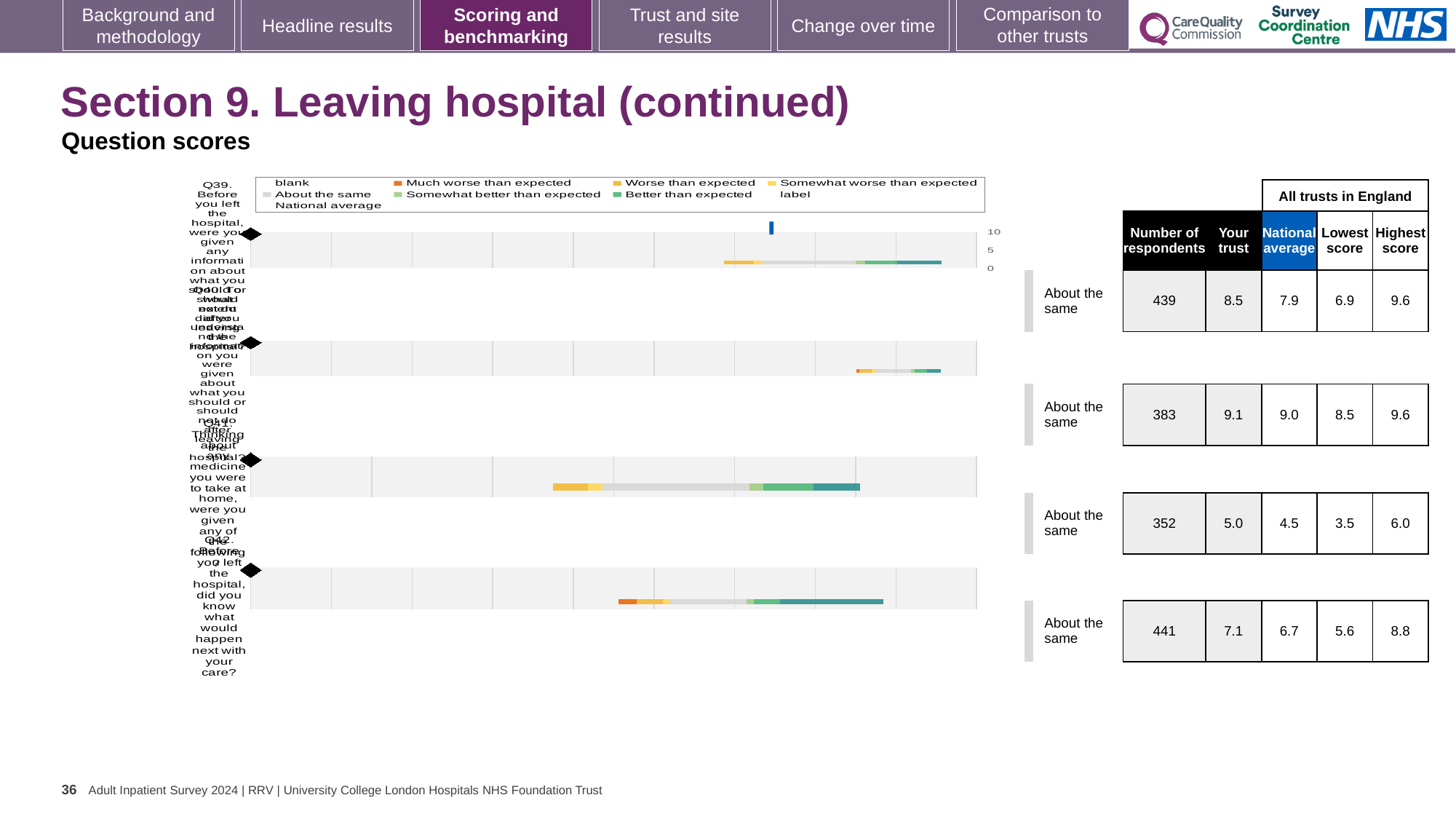
What kind of chart is shown on the slide? bar chart In the table, what is the national average for Q42 (the last row)? 6.7 How many entries does the chart legend list? 9 What is the highest tick value shown on the chart's axis? 10 Which row of the table has the highest 'Your trust' score? the second row (9.1) How many question rows (bars) are plotted in the chart? 4 Is the 'Your trust' score for Q42 (the last row) larger or smaller than its national average? larger In the table, what is the highest score in England for Q39 (the first row)? 9.6 What is the difference between the 'Your trust' score and the national average for Q39 (the first row)? 0.6 Which row of the table has the lowest 'Your trust' score? the third row (5.0) In the table, what is the 'Your trust' score for Q39 (the first row)? 8.5 In the table, what is the number of respondents for Q42 (the last row)? 441